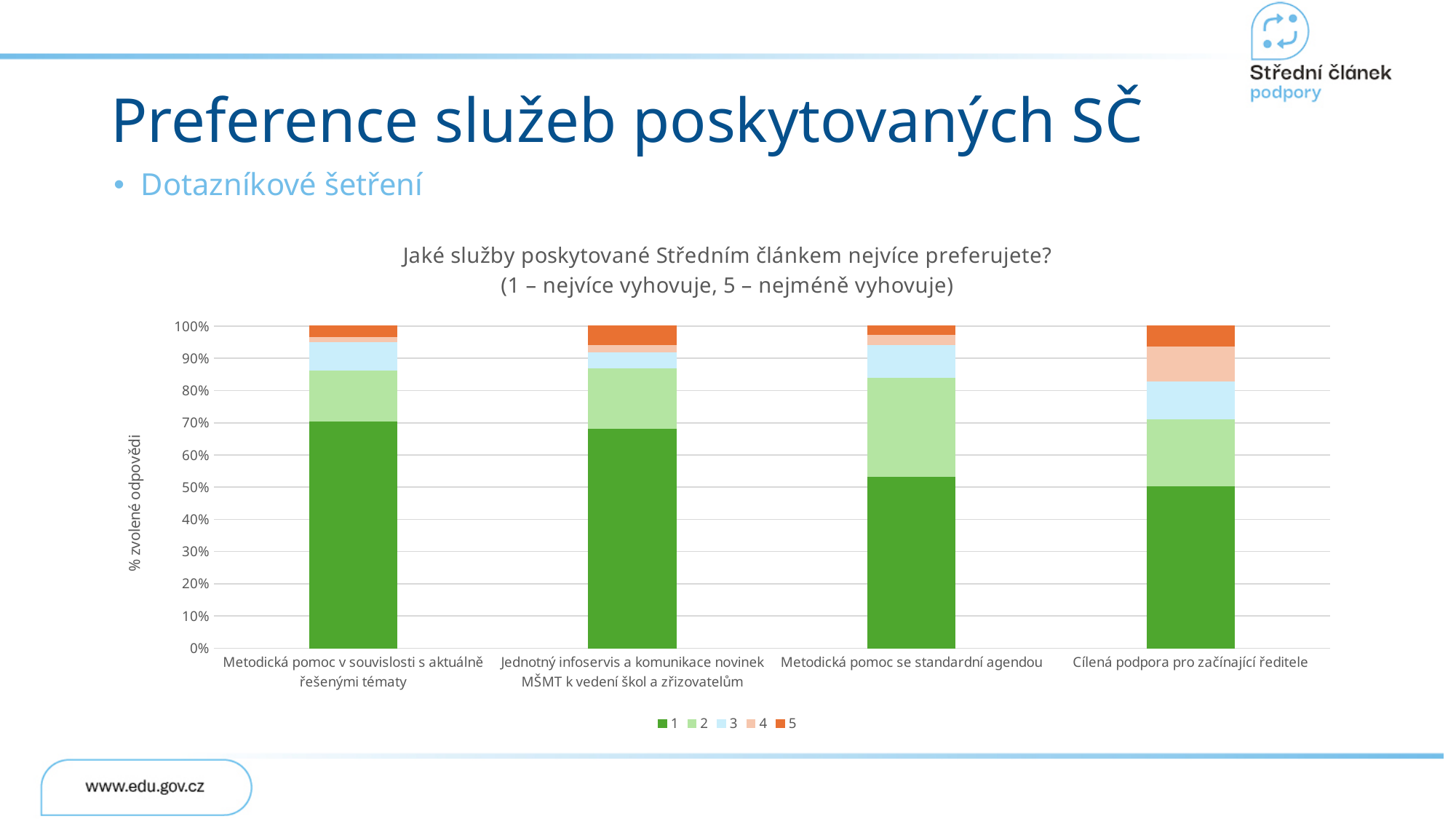
What is the label of the y axis of the chart? % zvolené odpovědi Is the value for series 1 in the category 'Jednotný infoservis a komunikace novinek MŠMT k vedení škol a zřizovatelům' greater or less than 60%? greater What kind of chart is shown on the slide? Stacked bar chart Which has a larger value for series 4: 'Cílená podpora pro začínající ředitele' or 'Metodická pomoc v souvislosti s aktuálně řešenými tématy'? Cílená podpora pro začínající ředitele What are the legend entries of the chart? 1, 2, 3, 4, 5 Which has a larger value for series 1: 'Metodická pomoc v souvislosti s aktuálně řešenými tématy' or 'Metodická pomoc se standardní agendou'? Metodická pomoc v souvislosti s aktuálně řešenými tématy How many series does the chart legend list? 5 What is the total height of the stacked bar for 'Cílená podpora pro začínající ředitele'? 100% Is the value for series 1 in the category 'Metodická pomoc v souvislosti s aktuálně řešenými tématy' greater or less than 60%? greater Is the value for series 1 in the category 'Cílená podpora pro začínající ředitele' greater or less than 60%? less How many categories (services) are shown on the x axis of the chart? 4